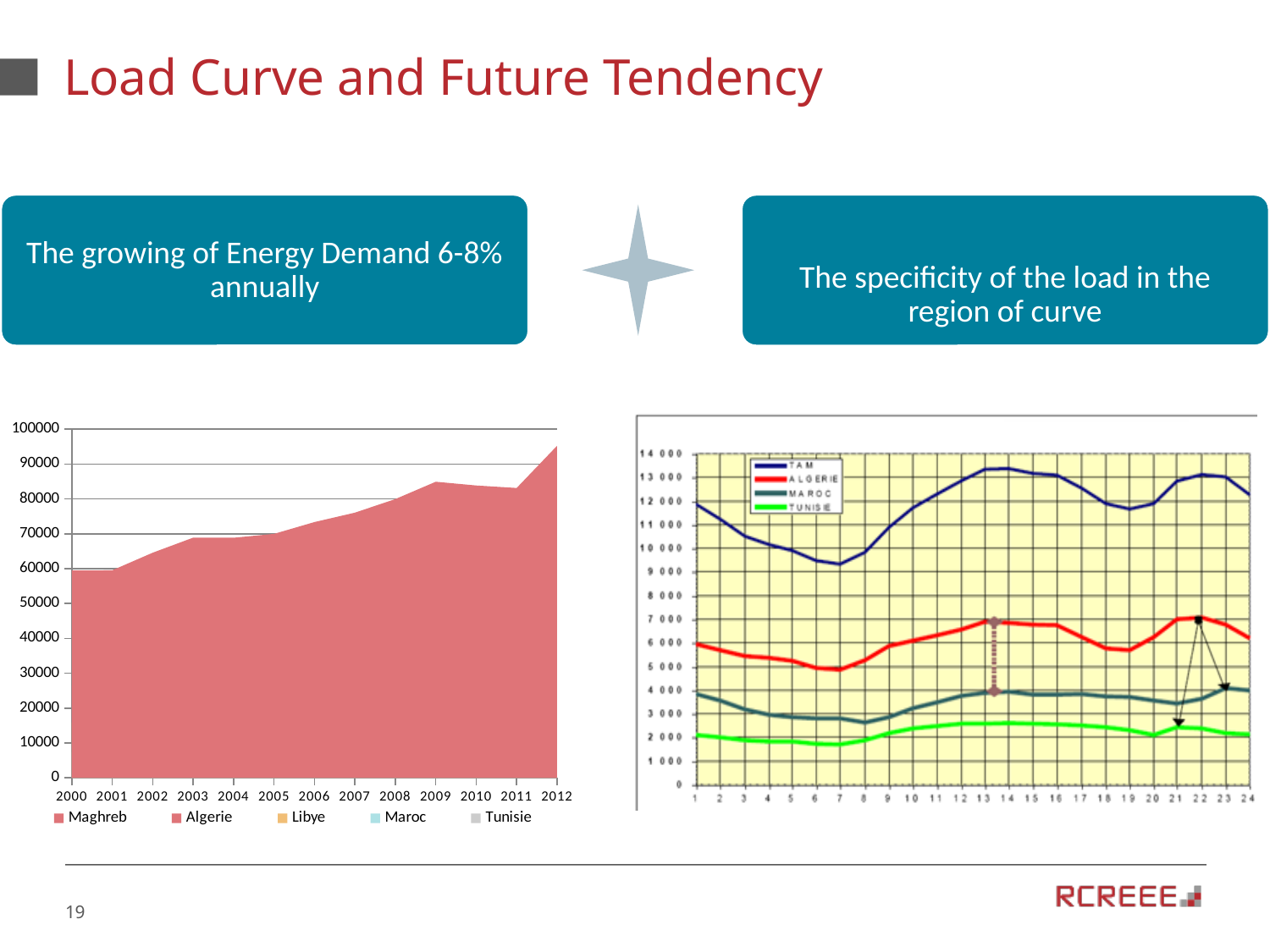
In the right chart, which series has the highest values across the day? TAM In the right chart, how many series does the legend list? 4 What type of chart is the chart on the left of the slide? area chart What type of chart is the chart on the right of the slide? line chart In the right chart, is the TAM value at hour 7 greater or less than 10 000? less In the left chart, do the values generally rise or fall from 2000 to 2012? rise In the left chart, is the value for 2012 greater or less than 90000? greater In the left chart, which year has the highest value? 2012 In the right chart, how many points are shown on the x axis? 24 In the left chart, is the value for 2009 greater or less than 80000? greater In the left chart, how many series does the legend list? 5 In the left chart, how many years are shown on the x axis? 13